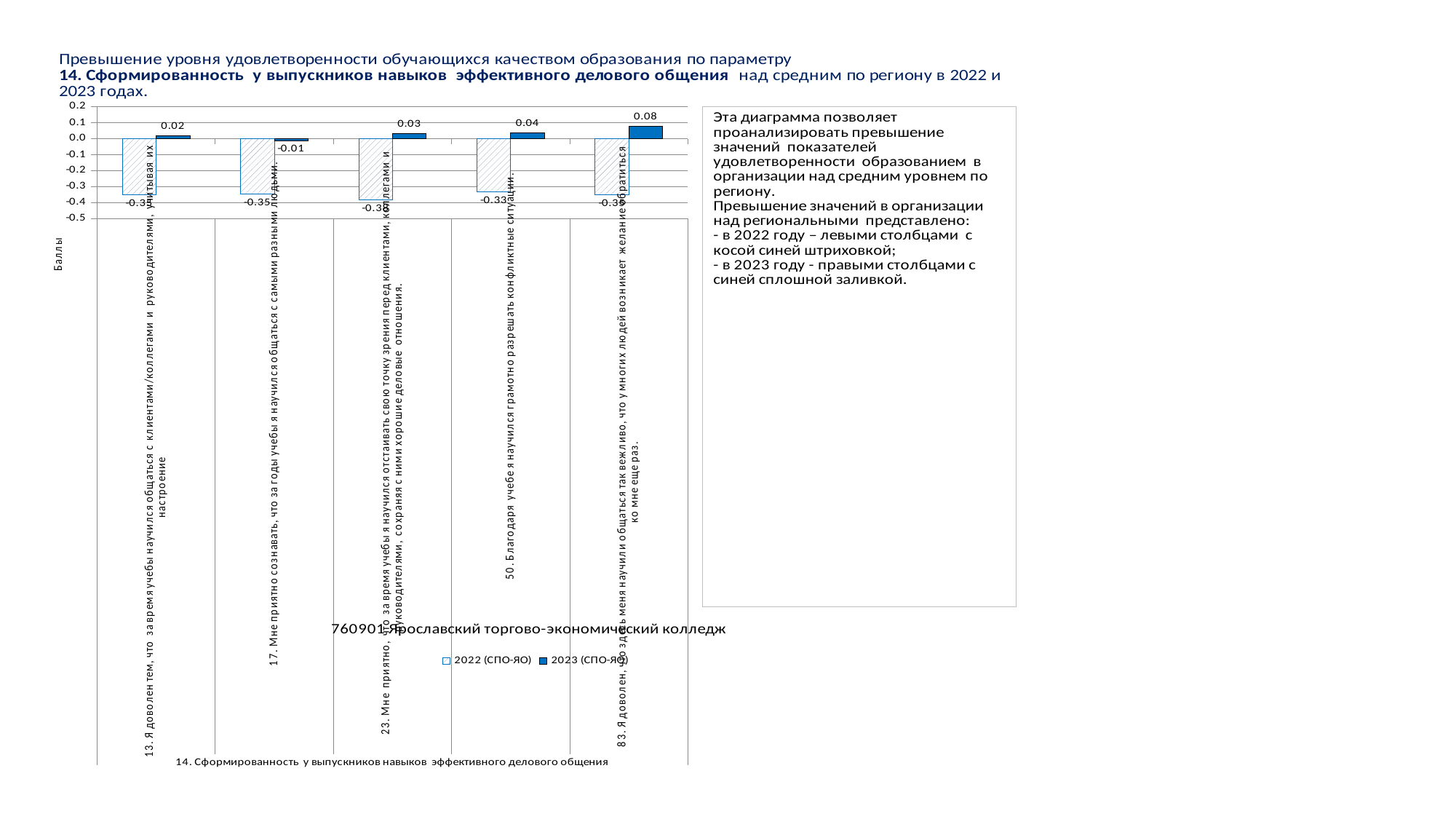
What is the 2023 (СПО-ЯО) value for statement 83 ("Я доволен, что здесь меня научили общаться так вежливо...")? 0.08 Which statement has the lowest 2023 (СПО-ЯО) value? 17 What is the difference between the 2023 (СПО-ЯО) values for statement 83 and statement 50? 0.04 What is the 2022 (СПО-ЯО) value for statement 23 ("Мне приятно, что за время учебы я научился отстаивать свою точку зрения...")? -0.38 Which statement has the highest 2023 (СПО-ЯО) value? 83 Which statement has the lowest 2022 (СПО-ЯО) value? 23 How many categories (statements) are plotted on the chart? 5 What kind of chart is shown on the slide? bar chart What is the 2023 (СПО-ЯО) value for statement 17 ("Мне приятно сознавать, что за годы учебы я научился общаться с самыми разными людьми")? -0.01 How many series does the chart legend list? 2 What is the 2022 (СПО-ЯО) value for statement 50 ("Благодаря учебе я научился грамотно разрешать конфликтные ситуации")? -0.33 What is the title of the vertical axis of the chart? Баллы